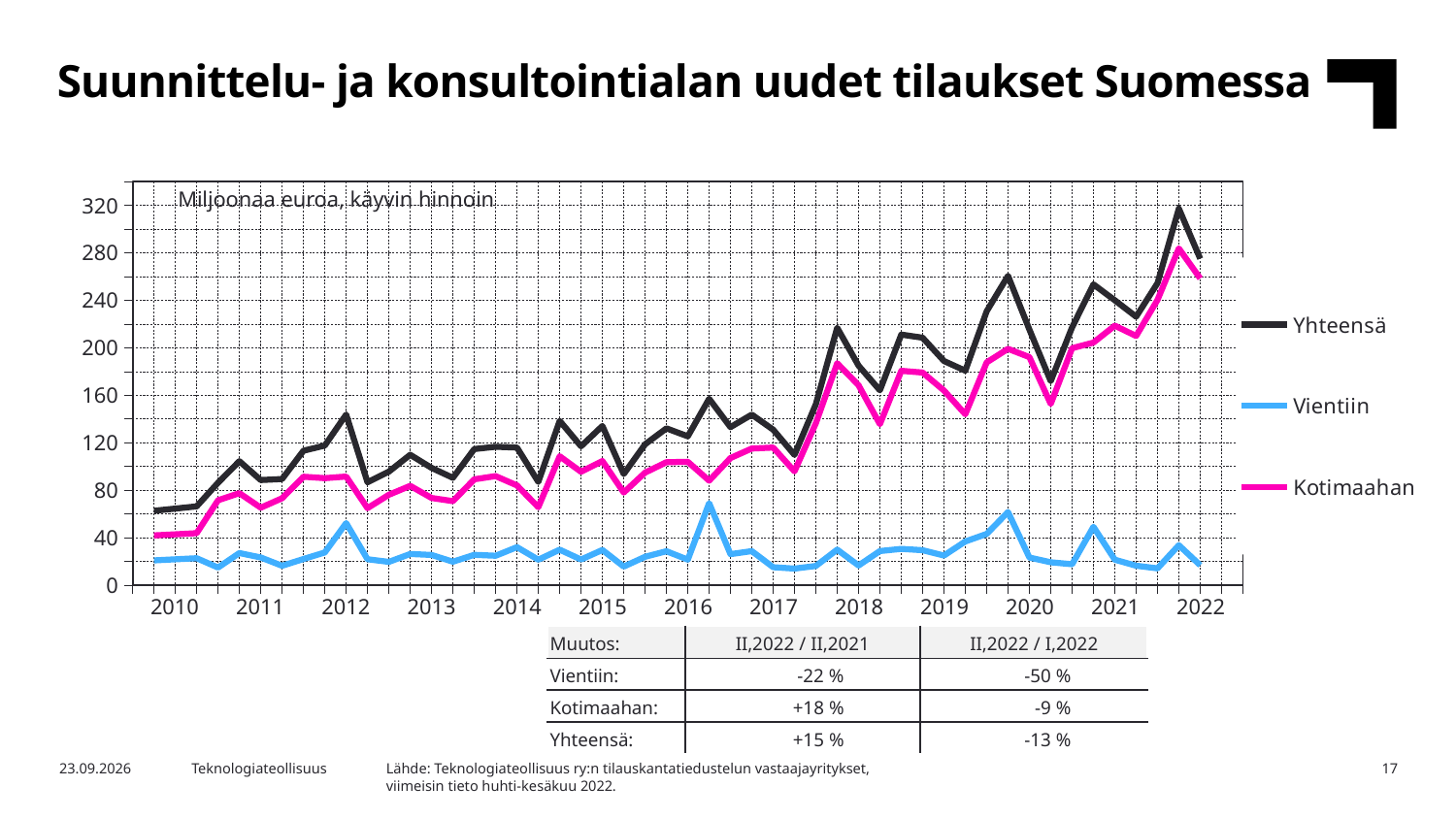
What are the series names listed in the legend? Yhteensä, Vientiin, Kotimaahan Is the value for Yhteensä at the start of 2010 greater or less than 80? less Does the Yhteensä series generally rise or fall from 2010 to 2022? rise How many series does the legend list? 3 What unit is stated in the chart's subtitle? Miljoonaa euroa, käyvin hinnoin Which series has the highest values throughout the chart? Yhteensä How many year labels are shown on the x axis? 13 Which series is larger in 2019, Kotimaahan or Vientiin? Kotimaahan Which series has the lowest values throughout the chart? Vientiin What kind of chart is shown on the slide? line chart Is the value for Vientiin at the start of 2010 greater or less than 40? less